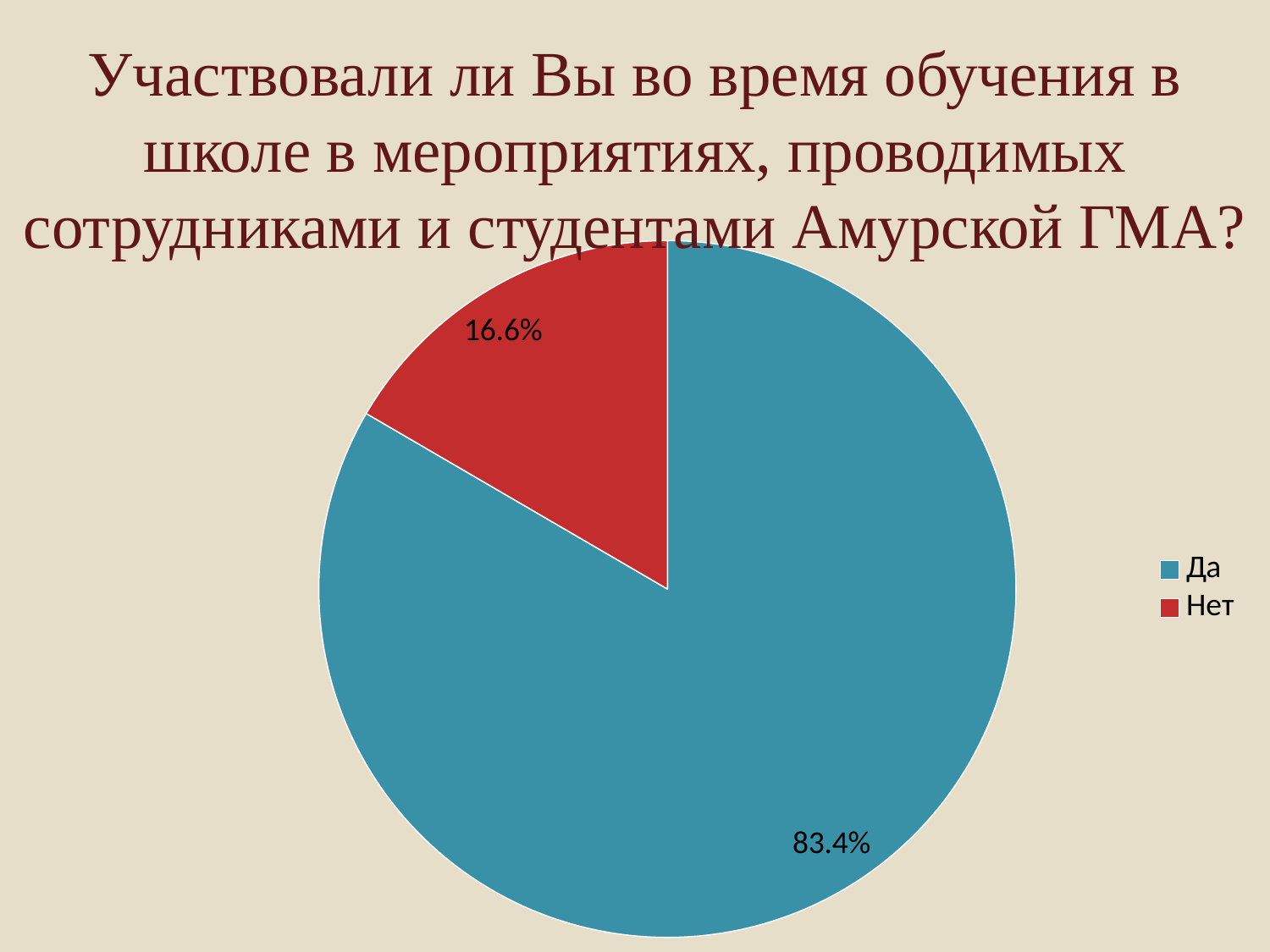
What share of the pie does "Да" represent? 83.4% How many categories are shown in the pie chart? 2 What colour is the "Да" slice? Blue What colour is the "Нет" slice? Red How many entries does the legend list? 2 Which category has the largest slice of the pie? Да What kind of chart is shown on the slide? Pie chart What is the difference in percentage points between the "Да" and "Нет" slices? 66.8 Which slice is larger, "Да" or "Нет"? Да Which category has the smallest slice of the pie? Нет What share of the pie does "Нет" represent? 16.6%